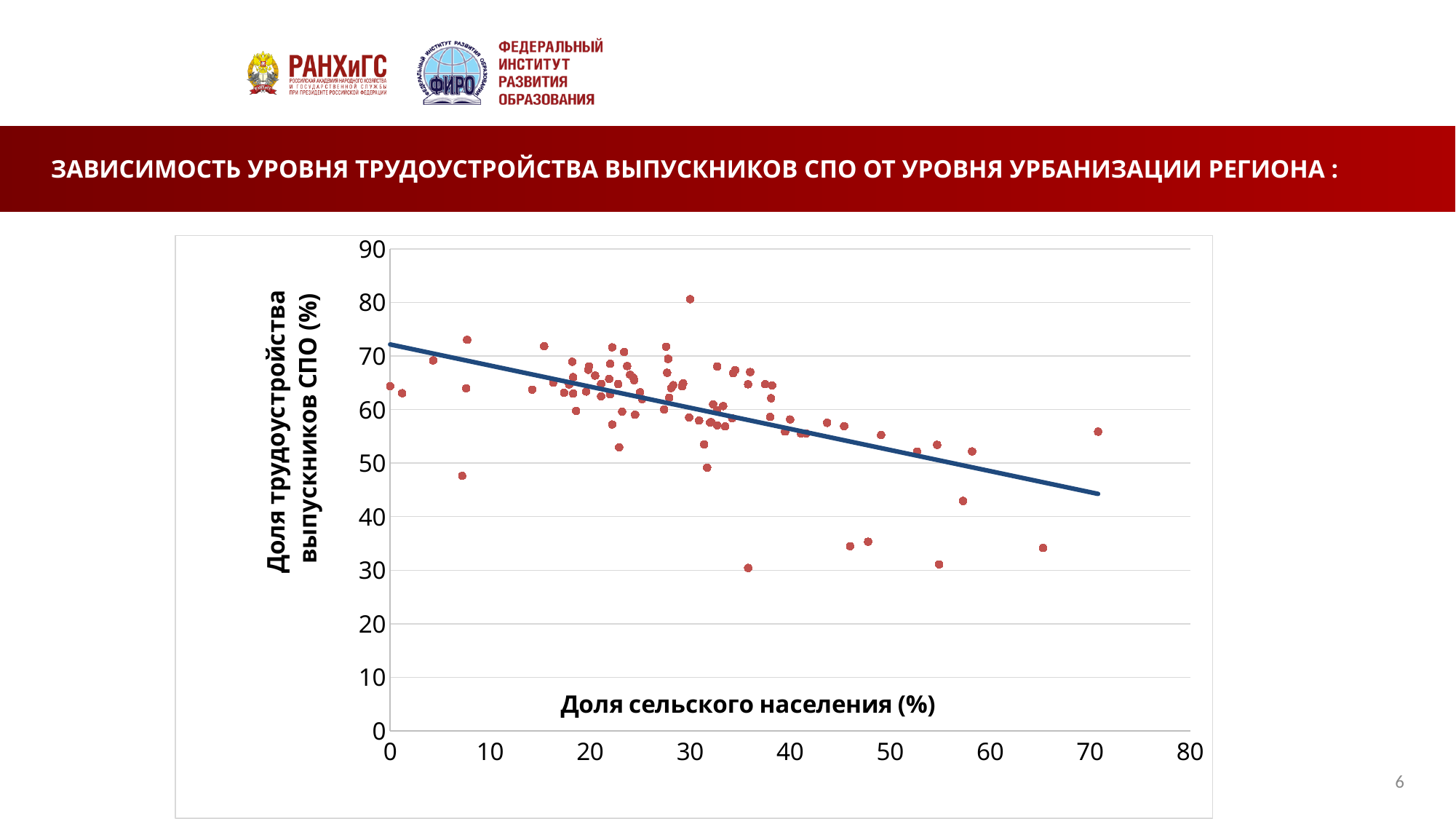
What is the label of the x axis of the chart? Доля сельского населения (%) What is the maximum value shown on the y axis of the chart? 90 What is the label of the y axis of the chart? Доля трудоустройства выпускников СПО (%) Is the lowest plotted point on the chart greater or less than 40 on the y axis? less Do the values on the chart generally rise or fall as the share of rural population increases along the x axis? fall Is the value of the trend line at a rural population share of 70% greater or less than 50? less What kind of chart is shown on the slide? scatter chart Is the employment share for the point with the highest rural population share (about 71%) greater or less than 50? greater